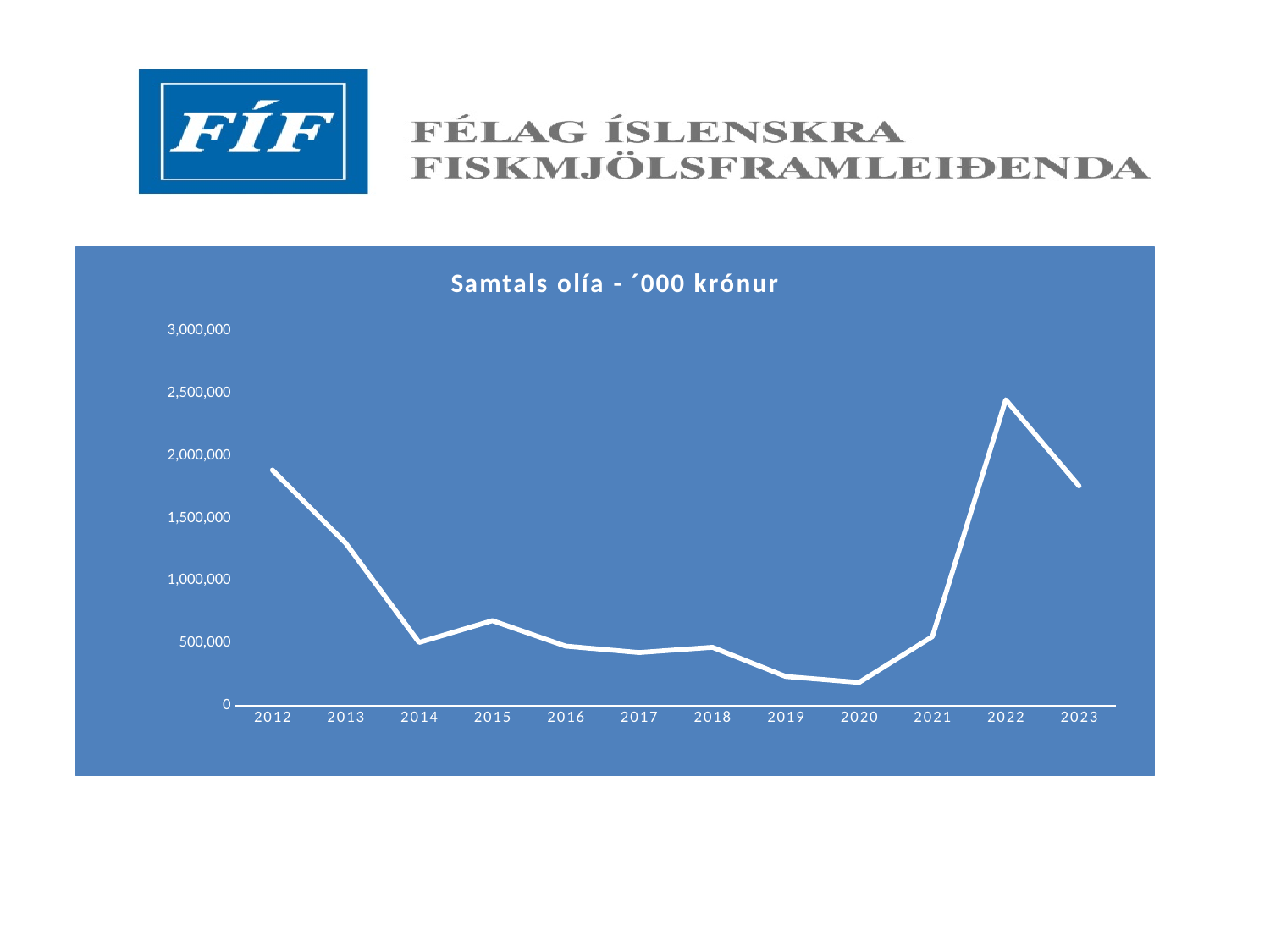
Do the values rise or fall from 2012 to 2014? fall Is the value for 2012 greater or less than 1,500,000? greater Is the value for 2022 greater or less than 2,000,000? greater What kind of chart is shown on the slide? line chart Is the value for 2020 greater or less than 500,000? less What is the title of the chart? Samtals olía - ´000 krónur Which is larger, the value for 2012 or the value for 2013? 2012 Which is larger, the value for 2022 or the value for 2023? 2022 How many years are plotted along the x axis? 12 Which year has the highest value? 2022